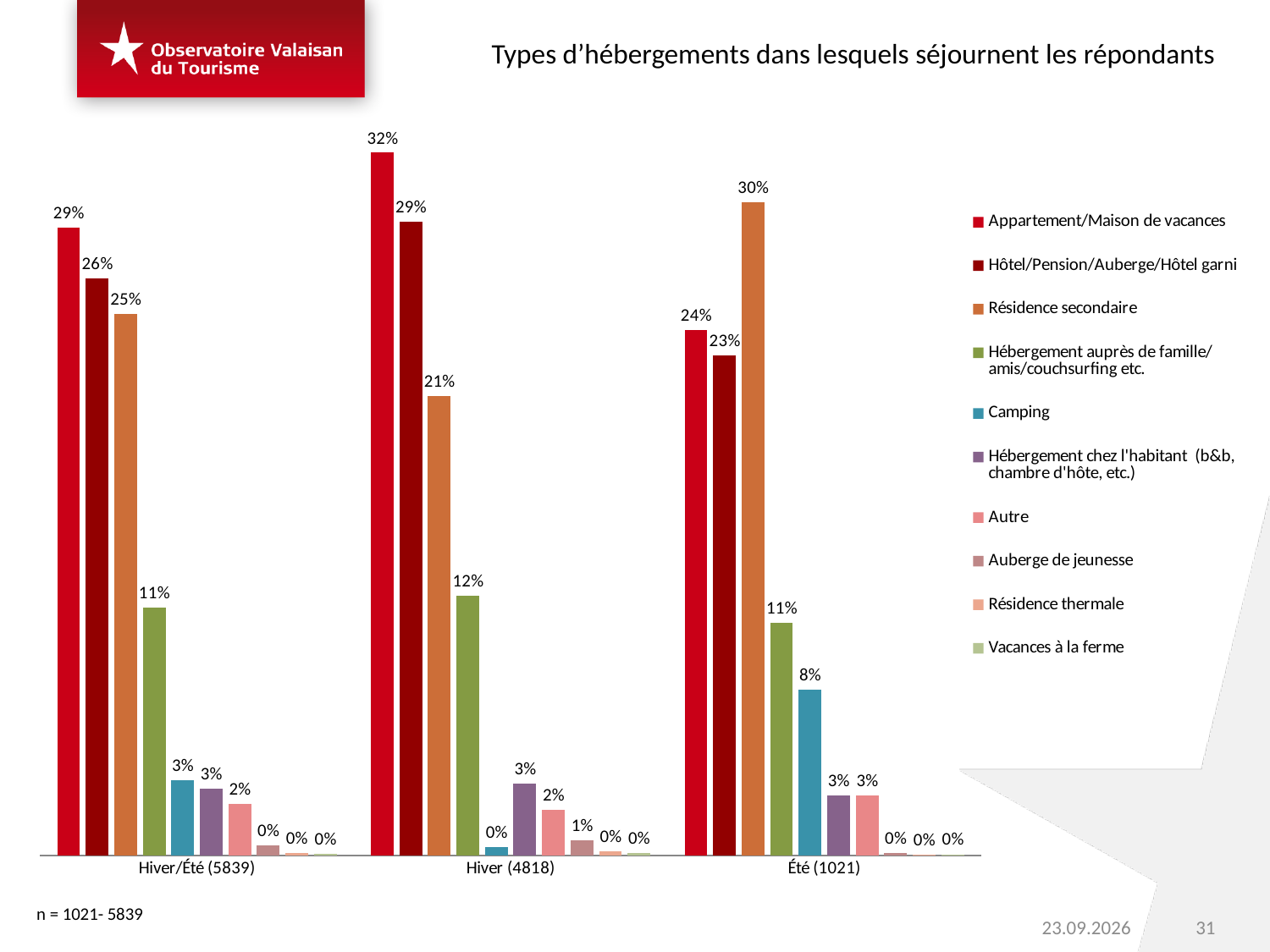
Which is larger: Camping in Hiver (4818) or Camping in Été (1021)? Camping in Été (1021) What is the value for Camping in the Été (1021) category? 8% How many series does the legend list? 10 Which accommodation type has the highest value in the Été (1021) category? Résidence secondaire How many categories are shown on the x axis? 3 What is the value for Appartement/Maison de vacances in the Hiver (4818) category? 32% What is the value for Hôtel/Pension/Auberge/Hôtel garni in the Hiver/Été (5839) category? 26% What is the difference between Appartement/Maison de vacances and Résidence secondaire in the Hiver (4818) category? 11% What kind of chart is shown on the slide? Bar chart Which accommodation type has the highest value in the Hiver (4818) category? Appartement/Maison de vacances What is the title of the chart? Types d'hébergements dans lesquels séjournent les répondants What is the value for Résidence secondaire in the Été (1021) category? 30%